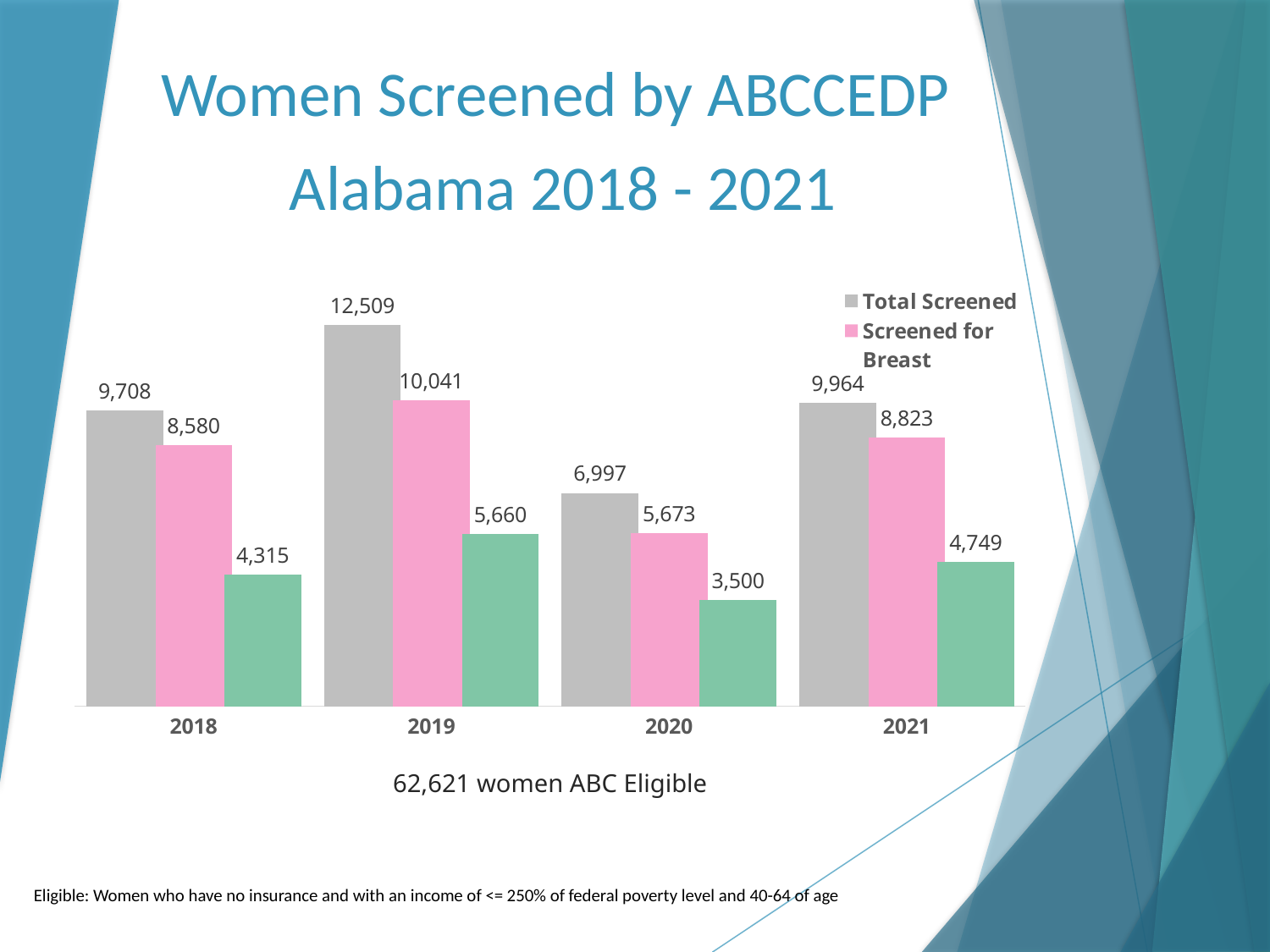
How many women were Screened for Breast in 2020? 5,673 How much higher is Total Screened in 2019 than in 2018? 2,801 In 2021, what is the difference between Total Screened and Screened for Breast? 1,141 What kind of chart is shown on the slide? Bar chart Which year has the highest Total Screened value? 2019 Between 2019 and 2020, did the Total Screened value rise or fall? Fall What colour are the Total Screened bars? Gray Which year has the lowest Screened for Breast value? 2020 What is the Screened for Breast value for 2018? 8,580 How many years are shown on the x axis? 4 Which year has the larger Total Screened value, 2018 or 2021? 2021 What is the Total Screened value for 2019? 12,509